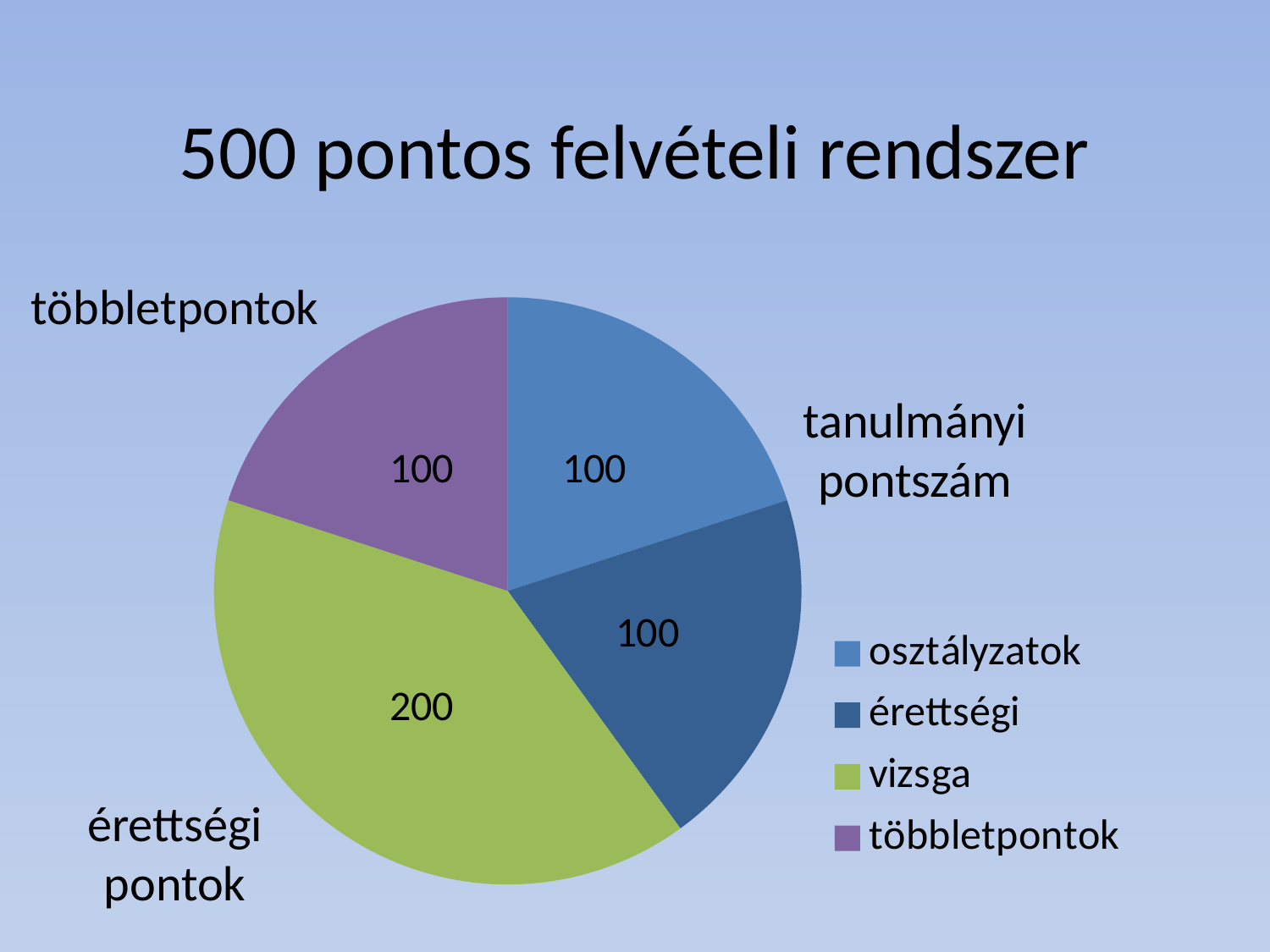
What is the value of the vizsga slice? 200 What is the value of the osztályzatok slice? 100 Which slice has the largest value? vizsga How many slices does the pie chart have? 4 What is the difference between the vizsga slice and the érettségi slice? 100 What is the title of the slide? 500 pontos felvételi rendszer How many entries does the legend list? 4 What kind of chart is shown on the slide? pie chart What share of the pie does the vizsga slice represent? 40% What is the value of the többletpontok slice? 100 Which is larger, the vizsga slice or the többletpontok slice? vizsga What is the value of the érettségi slice? 100